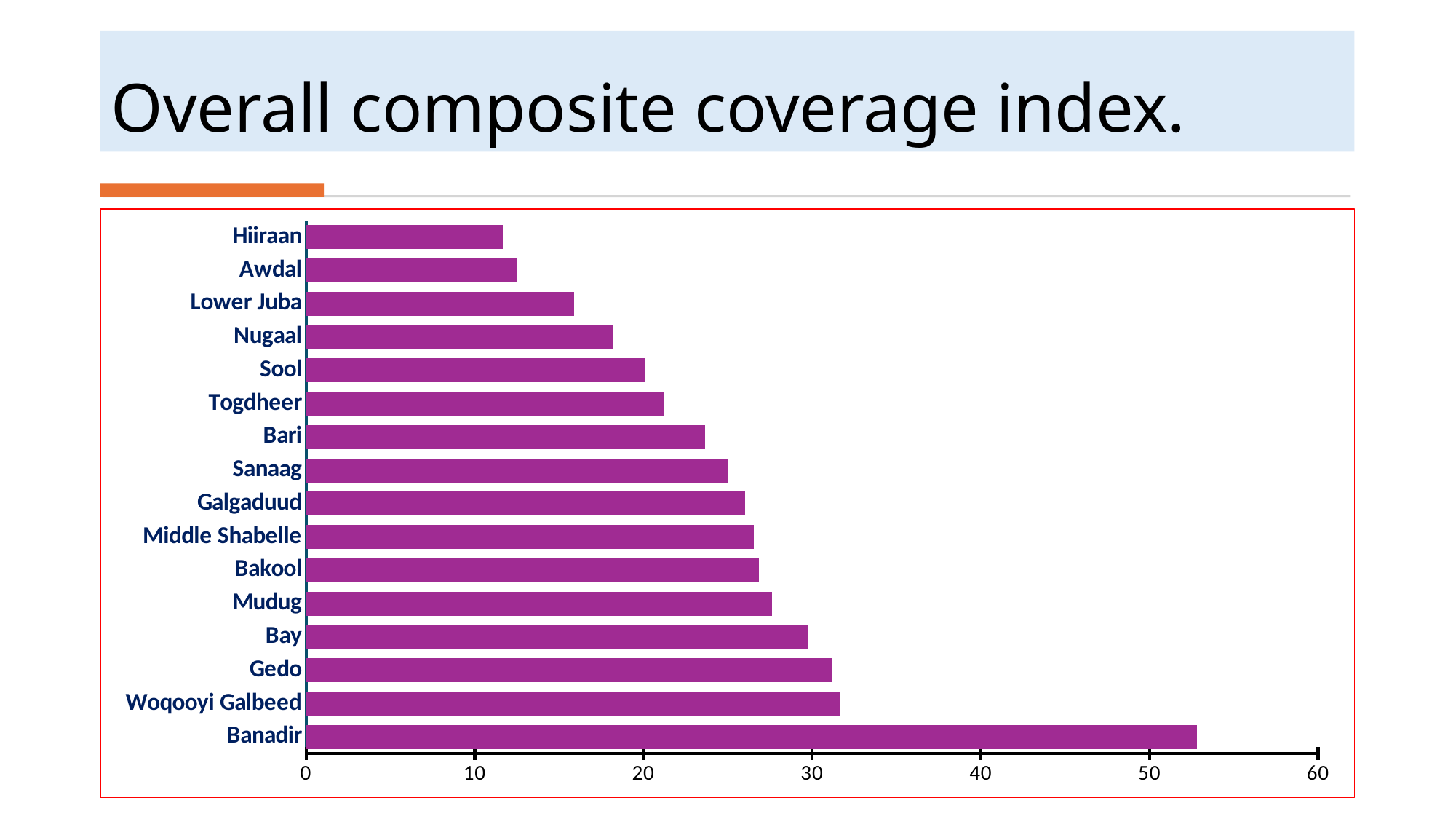
Is the value for Bari greater or less than 20? greater Which has a larger value, Bay or Sool? Bay How many regions are plotted in the chart? 16 Is the value for Mudug greater or less than 30? less What kind of chart is shown on the slide? bar chart Which region has the lowest overall composite coverage index? Hiiraan Which region has the highest overall composite coverage index? Banadir Is the value for Gedo greater or less than 30? greater What is the title of the slide containing the chart? Overall composite coverage index. Which has a larger value, Hiiraan or Nugaal? Nugaal